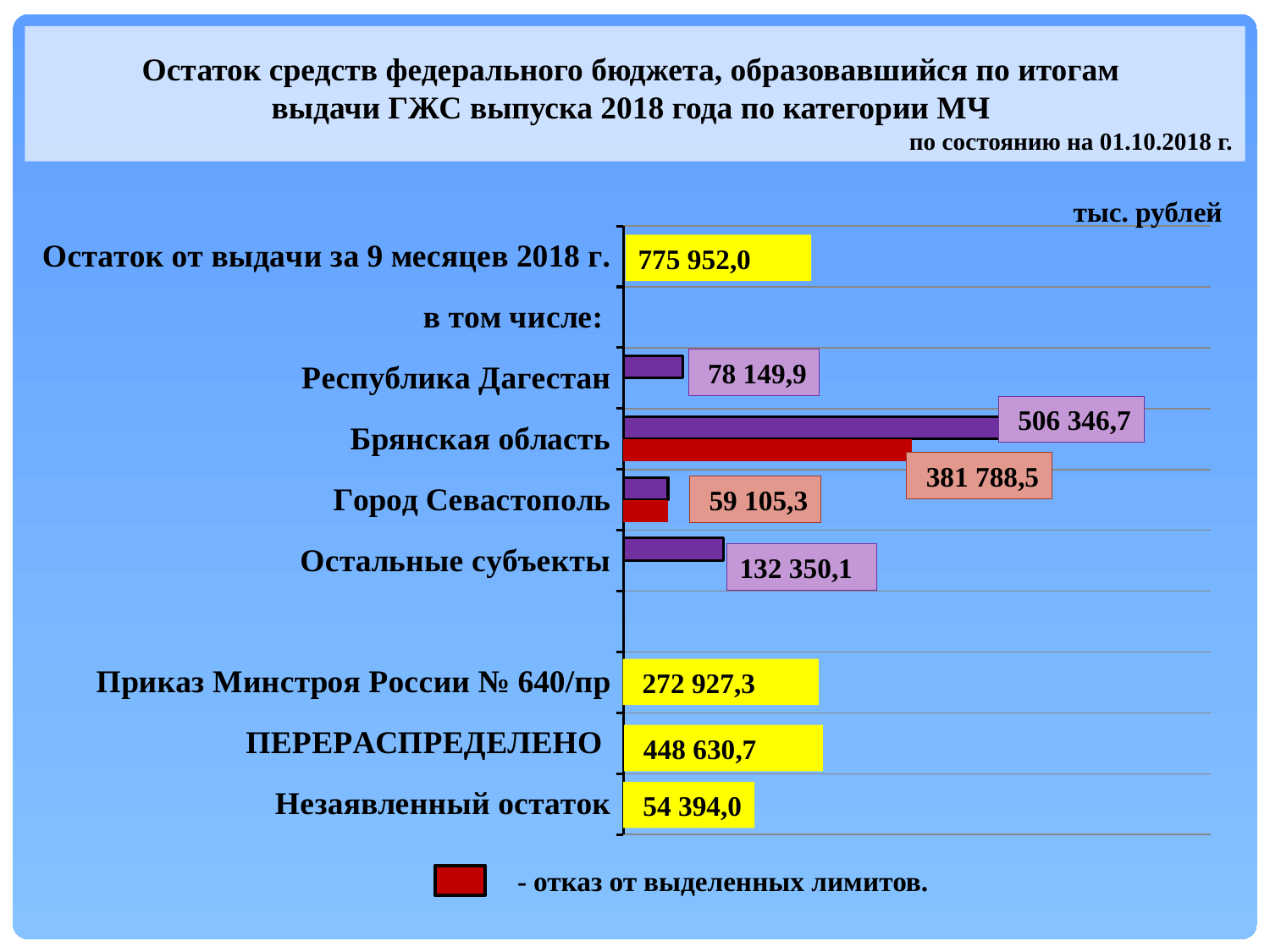
Which is larger, the value for «Республика Дагестан» or for «Остальные субъекты»? Остальные субъекты Among the regions listed under «в том числе», which has the largest purple bar? Брянская область What is the value shown for «Остаток от выдачи за 9 месяцев 2018 г.»? 775 952,0 What is the value shown for «Приказ Минстроя России № 640/пр»? 272 927,3 In what units are the values on the chart expressed? тыс. рублей What value is labelled for «Остальные субъекты»? 132 350,1 What is the difference between the values for «ПЕРЕРАСПРЕДЕЛЕНО» and «Приказ Минстроя России № 640/пр»? 175 703,4 What is the value of the purple bar for «Брянская область»? 506 346,7 What is the value shown for «Незаявленный остаток»? 54 394,0 What is the value shown for «ПЕРЕРАСПРЕДЕЛЕНО»? 448 630,7 What value is labelled for «Республика Дагестан»? 78 149,9 What is the value of the red bar (отказ от выделенных лимитов) for «Брянская область»? 381 788,5